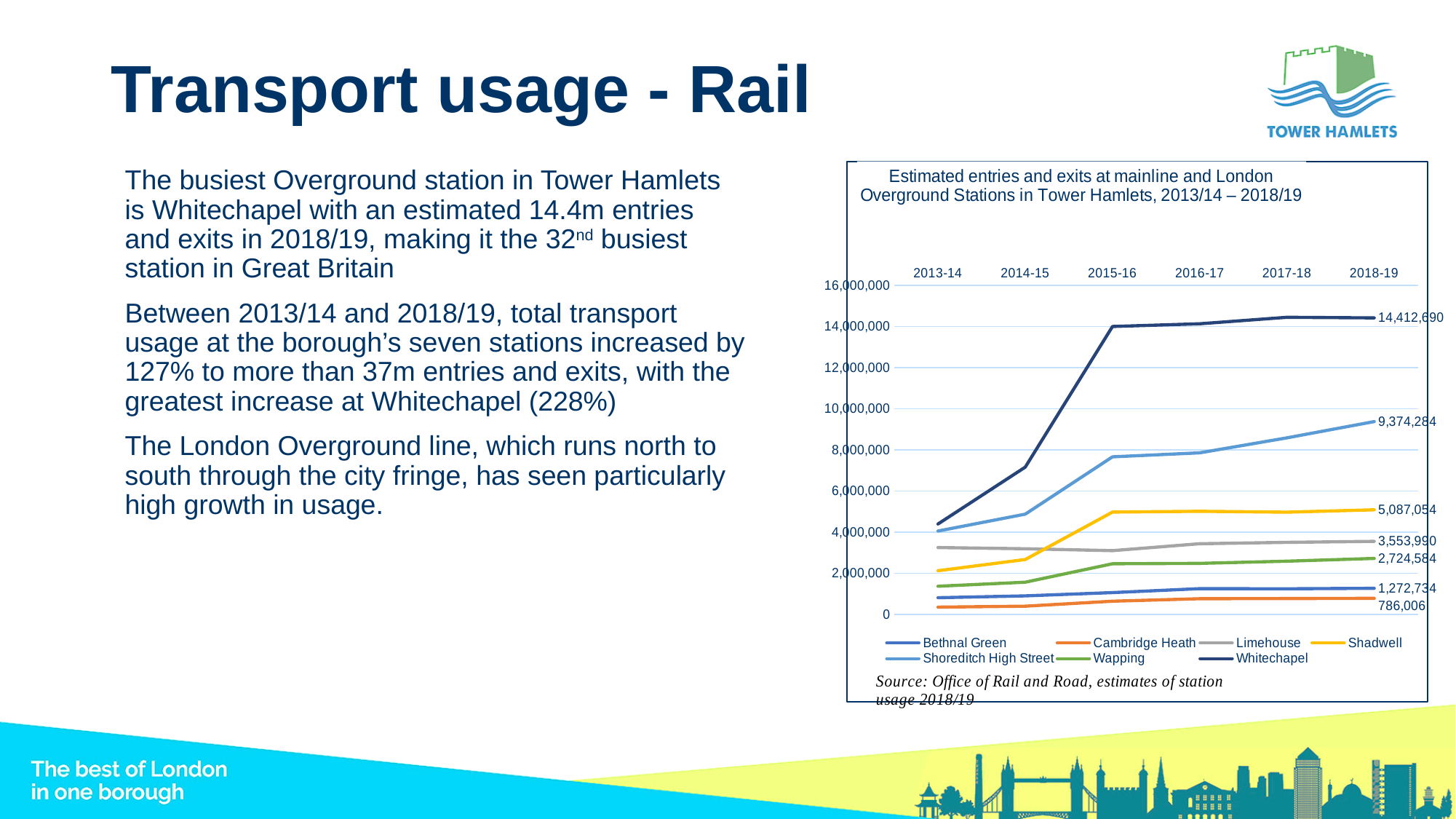
What is the value for Shoreditch High Street in 2018-19? 9,374,284 Does the Whitechapel line rise or fall between 2013-14 and 2018-19? Rise What is the value for Cambridge Heath in 2018-19? 786,006 What is the difference between the 2018-19 values for Whitechapel and Shoreditch High Street? 5,038,406 Is the value for Whitechapel in 2013-14 greater or less than 6,000,000? less How many years are plotted along the x axis of the chart? 6 Which station has the lowest value in 2018-19? Cambridge Heath What type of chart is shown on the slide? Line chart What is the value for Whitechapel in 2018-19? 14,412,690 How many series does the chart legend list? 7 Which station has the highest value in 2018-19? Whitechapel What is the value for Shadwell in 2018-19? 5,087,054